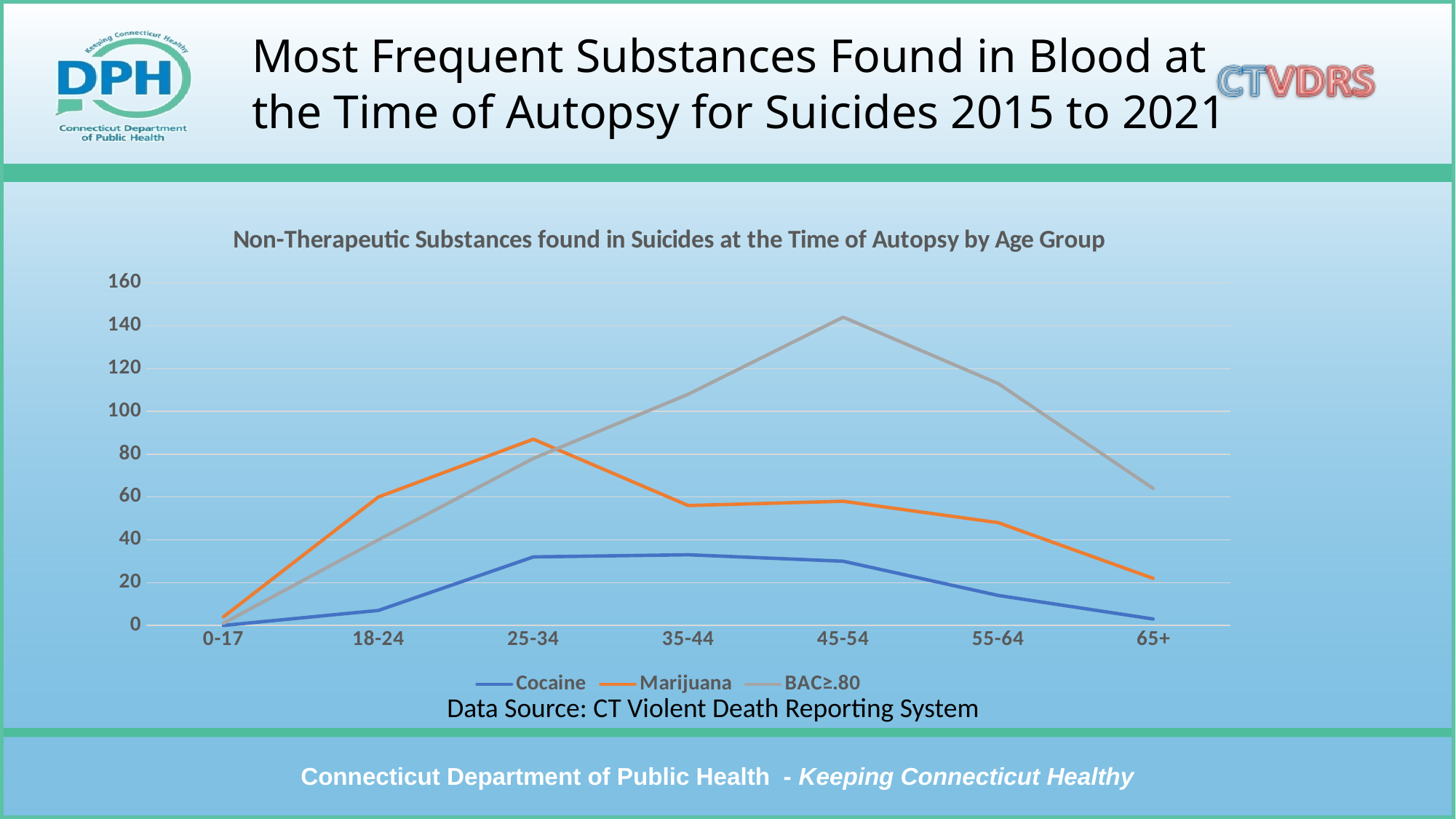
Does the BAC≥.80 line rise or fall from the 0-17 age group to the 45-54 age group? rise Is the value for Cocaine in the 25-34 age group greater or less than 40? less How many series does the chart's legend list? 3 How many age groups are shown on the x axis of the chart? 7 Which age group has the lowest value for Cocaine? 0-17 What is the title of the chart? Non-Therapeutic Substances found in Suicides at the Time of Autopsy by Age Group What kind of chart is shown on the slide? line chart Is the value for Marijuana in the 18-24 age group greater or less than 40? greater Which age group has the highest value for Marijuana? 25-34 In the 45-54 age group, which is larger: BAC≥.80 or Marijuana? BAC≥.80 Is the value for BAC≥.80 in the 35-44 age group greater or less than 100? greater Which age group has the highest value for BAC≥.80? 45-54